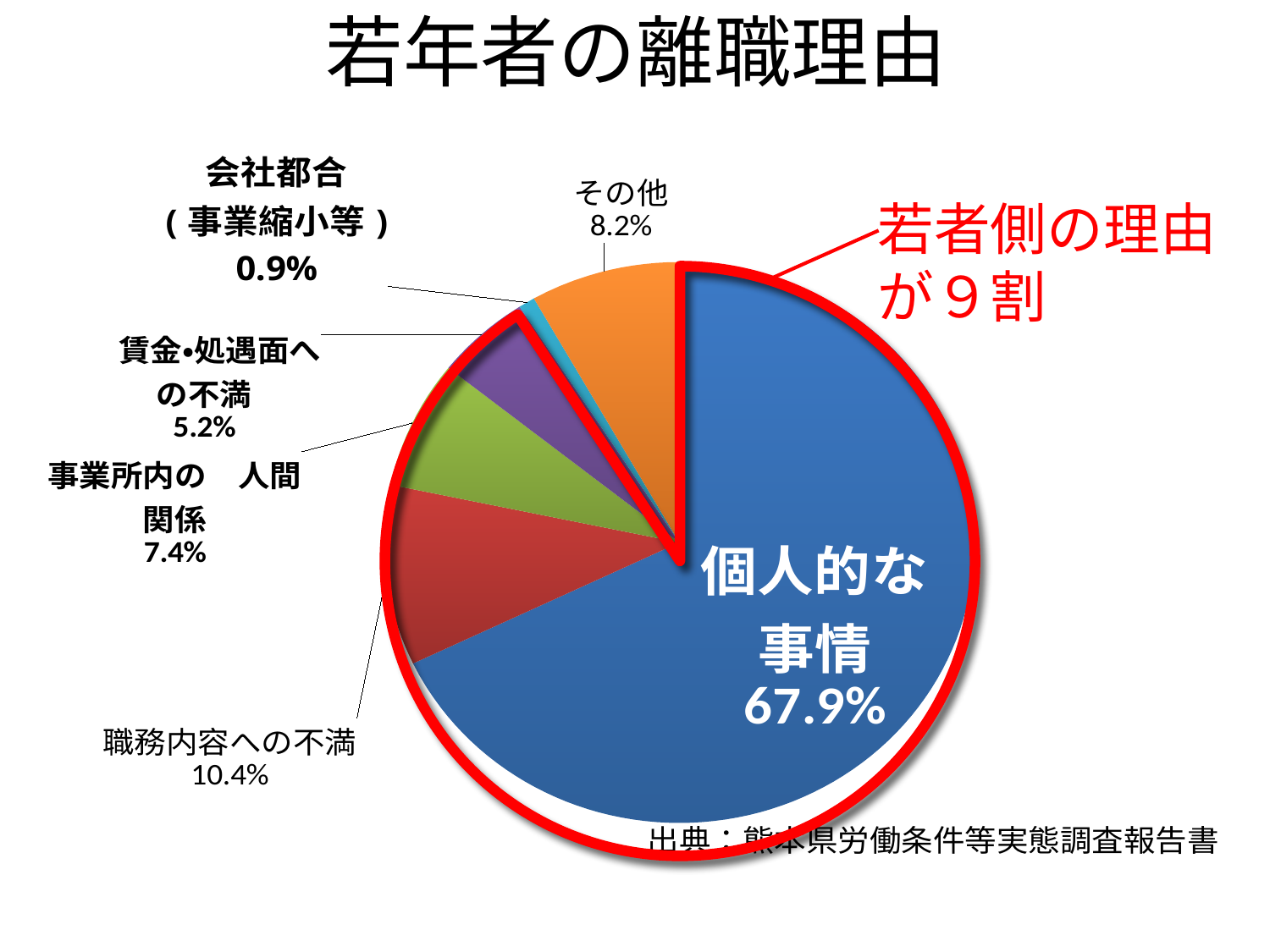
What is the title of the chart? 若年者の離職理由 What percentage is shown for 事業所内の人間関係? 7.4% Which slice of the pie is the largest? 個人的な事情 Which slice of the pie is the smallest? 会社都合（事業縮小等） What percentage is shown for 個人的な事情? 67.9% What kind of chart is shown on the slide? pie chart How many slices does the pie chart have? 6 What percentage is shown for 職務内容への不満? 10.4% What percentage is shown for その他? 8.2% What percentage is shown for 会社都合（事業縮小等）? 0.9% What is the difference between the percentages for 職務内容への不満 and 事業所内の人間関係? 3.0% What percentage is shown for 賃金・処遇面への不満? 5.2%